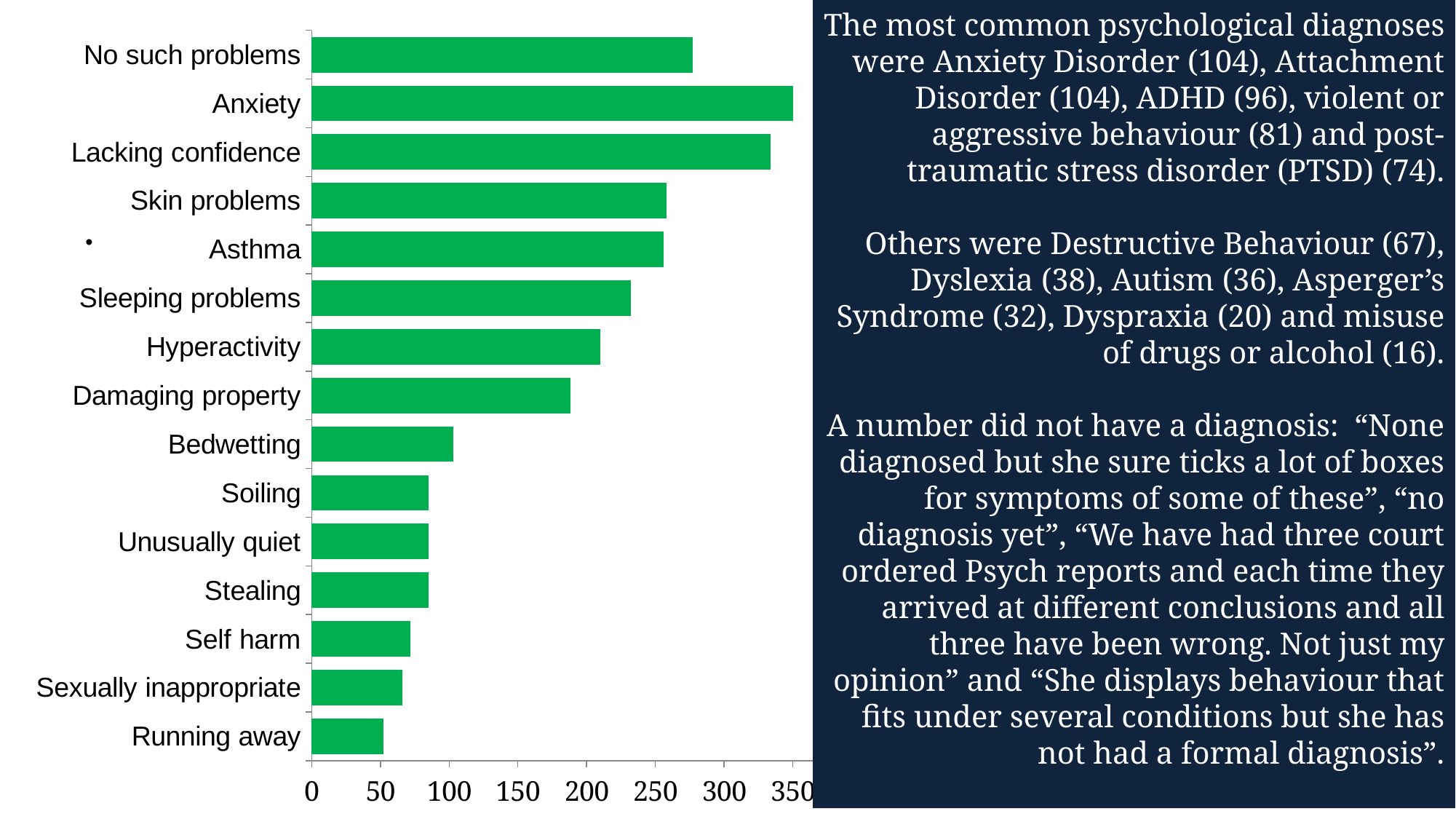
Is the value for Hyperactivity greater or less than 200? greater Which category has the highest value in the bar chart? Anxiety What kind of chart is shown on the slide? bar chart Which is larger, the value for Anxiety or the value for No such problems? Anxiety Is the value for Running away greater or less than 100? less Is the value for Bedwetting greater or less than 150? less Which category has the lowest value in the bar chart? Running away How many categories are plotted in the bar chart? 15 Which is larger, the value for Hyperactivity or the value for Bedwetting? Hyperactivity What is the highest tick value shown on the horizontal axis of the bar chart? 350